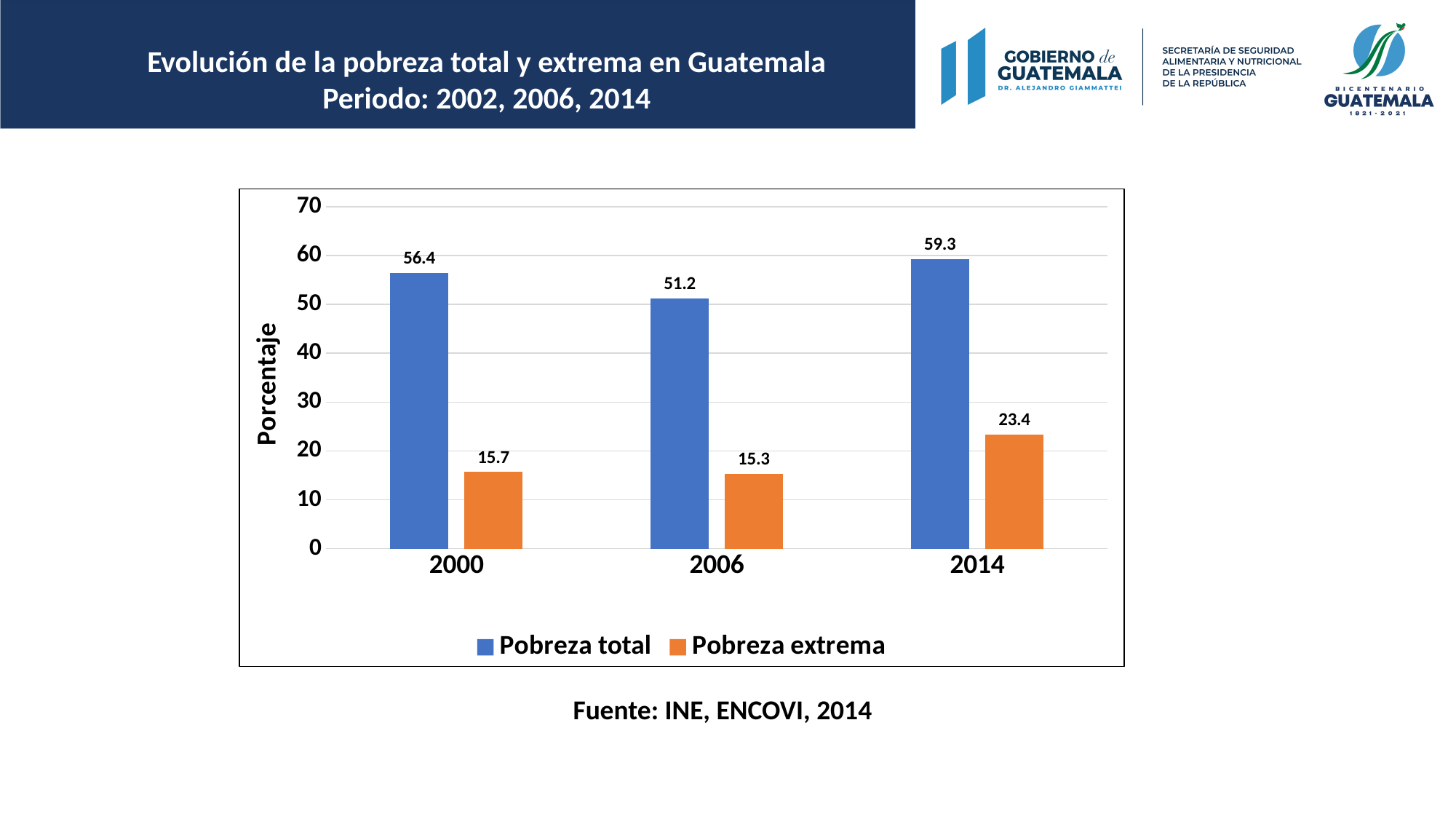
What is the value of Pobreza total for 2006? 51.2 What kind of chart is shown on the slide? Bar chart In which year is Pobreza extrema lowest? 2006 Does Pobreza total rise or fall from 2006 to 2014? Rise What is the label of the y axis? Porcentaje Which is larger, Pobreza extrema in 2000 or Pobreza extrema in 2014? Pobreza extrema in 2014 How many series does the legend list? 2 How many years are shown on the x axis? 3 What is the value of Pobreza total for 2000? 56.4 What is the difference between Pobreza total and Pobreza extrema in 2014? 35.9 In which year is Pobreza total highest? 2014 What is the value of Pobreza extrema for 2014? 23.4